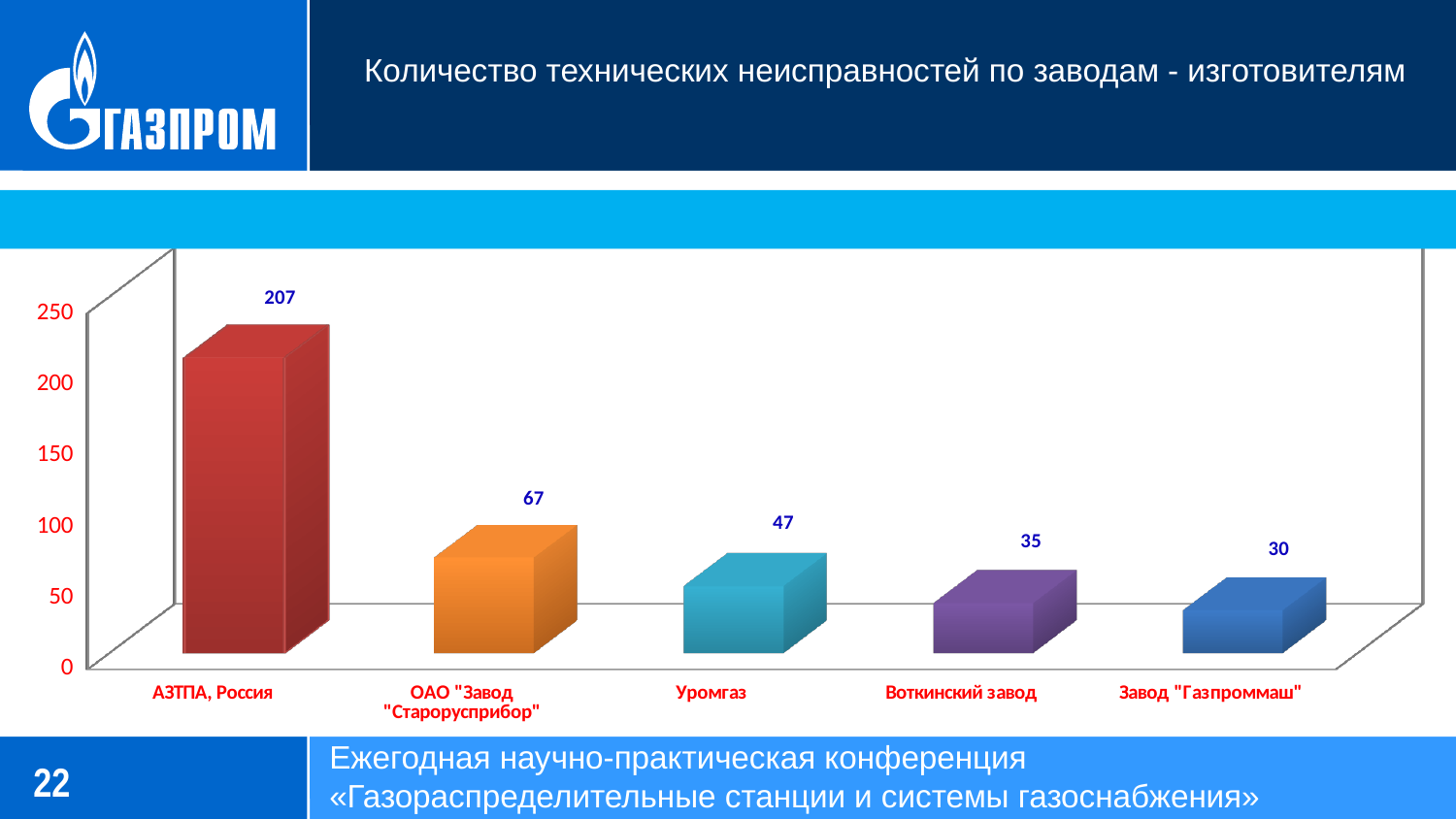
What is the number of technical faults for АЗТПА, Россия? 207 What kind of chart is shown on the slide? Bar chart What is the title of the slide? Количество технических неисправностей по заводам - изготовителям What is the value shown for Уромгаз? 47 What is the value shown for Воткинский завод? 35 What is the difference between the values for АЗТПА, Россия and ОАО "Завод "Старорусприбор"? 140 Which manufacturer has the lowest number of technical faults? Завод "Газпроммаш" How many manufacturers are shown on the chart? 5 What is the value shown for ОАО "Завод "Старорусприбор"? 67 What is the value shown for Завод "Газпроммаш"? 30 Which manufacturer has the highest number of technical faults? АЗТПА, Россия Which has a larger value, Уромгаз or Воткинский завод? Уромгаз